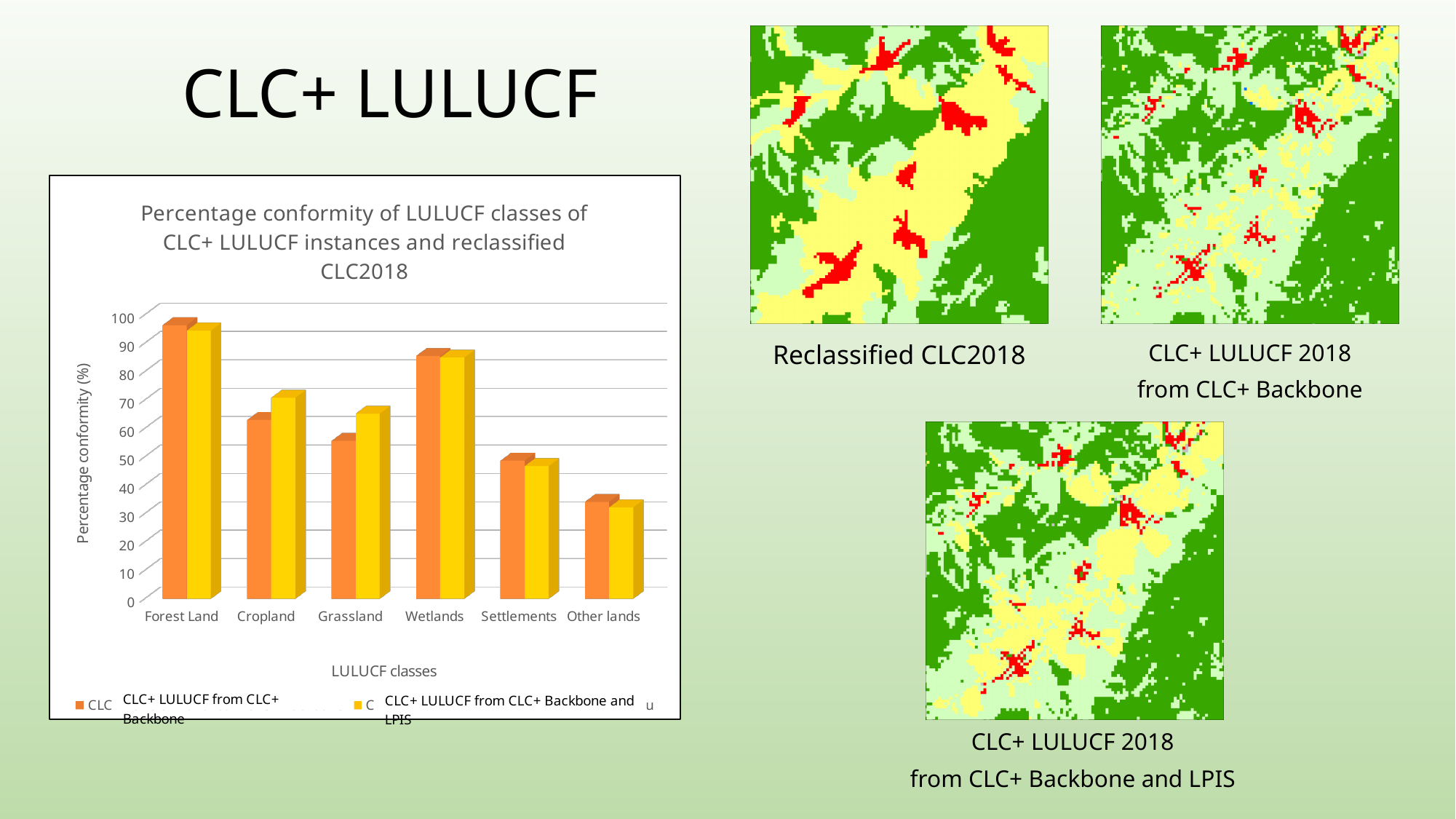
What is the label of the vertical axis of the chart? Percentage conformity (%) Is the percentage conformity for Forest Land in the CLC+ LULUCF from CLC+ Backbone series greater or less than 90? greater Which LULUCF class has the lowest percentage conformity for the CLC+ LULUCF from CLC+ Backbone and LPIS series? Other lands Is the percentage conformity for Other lands in the CLC+ LULUCF from CLC+ Backbone and LPIS series greater or less than 40? less How many series does the chart's legend list? 2 Which LULUCF class has the highest percentage conformity for the CLC+ LULUCF from CLC+ Backbone series? Forest Land Is the percentage conformity for Settlements in the CLC+ LULUCF from CLC+ Backbone series greater or less than 60? less How many LULUCF classes are shown on the x axis of the chart? 6 What kind of chart is shown on the slide? bar chart For Grassland, which series has the higher percentage conformity: CLC+ LULUCF from CLC+ Backbone or CLC+ LULUCF from CLC+ Backbone and LPIS? CLC+ LULUCF from CLC+ Backbone and LPIS For Cropland, which series has the higher percentage conformity: CLC+ LULUCF from CLC+ Backbone or CLC+ LULUCF from CLC+ Backbone and LPIS? CLC+ LULUCF from CLC+ Backbone and LPIS